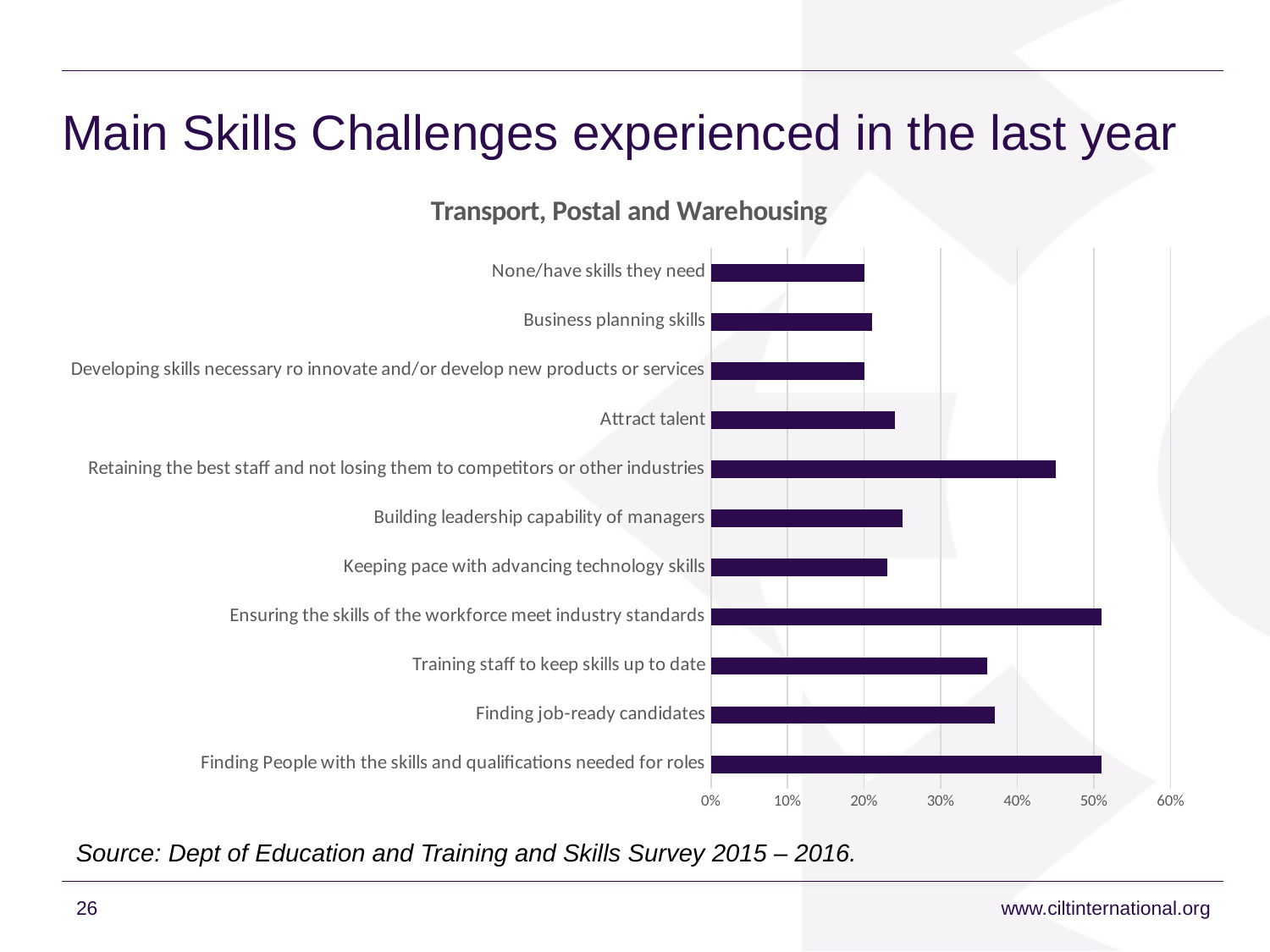
What is the highest value shown on the horizontal axis of the chart? 60% Which has the larger value: 'Attract talent' or 'Finding job-ready candidates'? Finding job-ready candidates Is the value for 'Training staff to keep skills up to date' greater or less than 30%? greater How many skills challenge categories are plotted in the chart? 11 What is the title of the chart? Transport, Postal and Warehousing Is the value for 'Finding job-ready candidates' greater or less than 40%? less Which has the larger value: 'Retaining the best staff and not losing them to competitors or other industries' or 'Training staff to keep skills up to date'? Retaining the best staff and not losing them to competitors or other industries Is the value for 'Retaining the best staff and not losing them to competitors or other industries' greater or less than 40%? greater What kind of chart is shown on the slide? bar chart